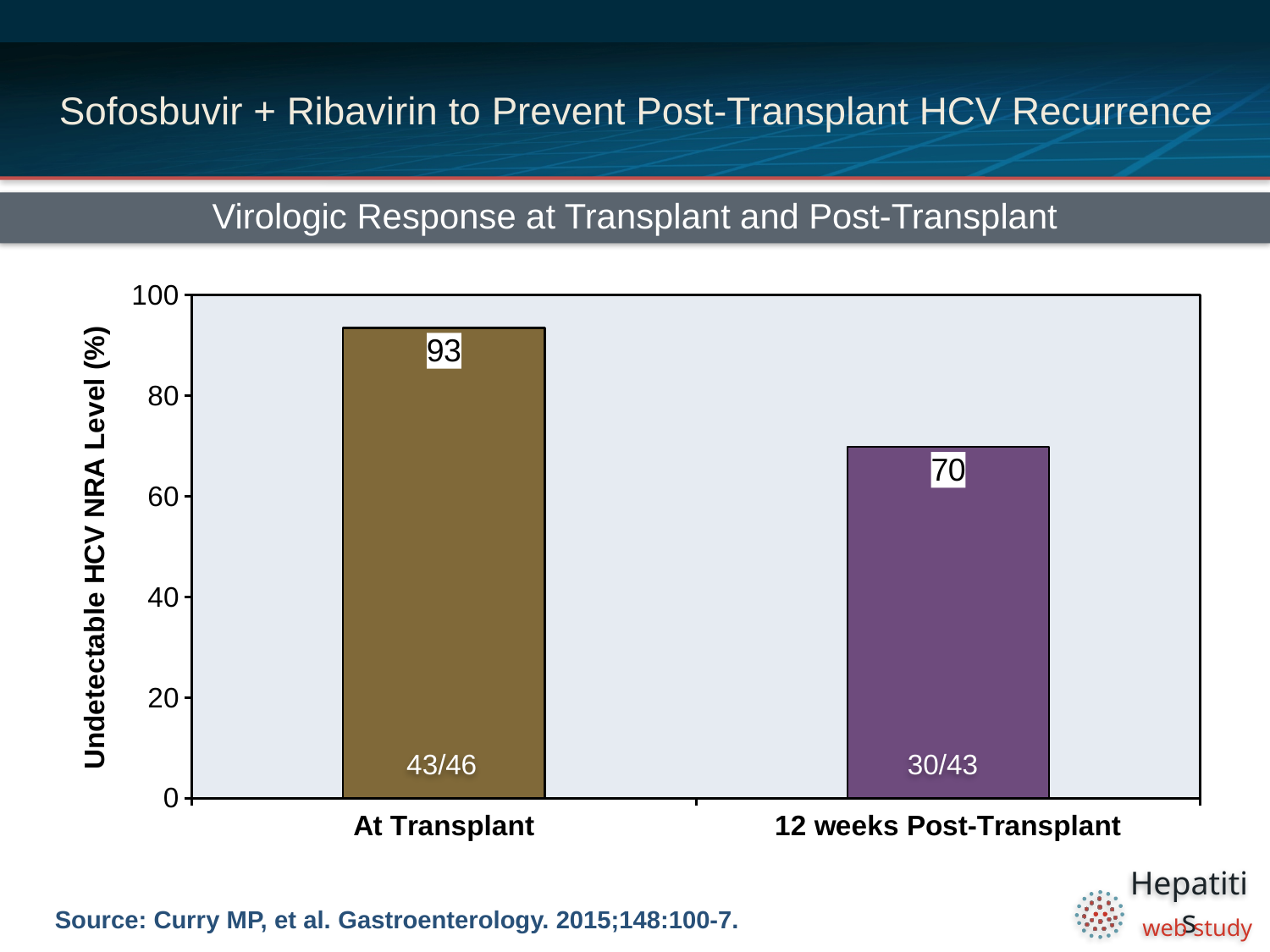
What is the value for 12 weeks Post-Transplant? 70 What kind of chart is shown on the slide? bar chart Which category has the lowest value? 12 weeks Post-Transplant Which category has the highest value? At Transplant Is the value for 12 weeks Post-Transplant greater or less than 80? less What fraction is printed inside the At Transplant bar? 43/46 What is the title of the chart? Virologic Response at Transplant and Post-Transplant What is the value for At Transplant? 93 What is the difference between the values for At Transplant and 12 weeks Post-Transplant? 23 Which is larger, the value for At Transplant or for 12 weeks Post-Transplant? At Transplant Do the values rise or fall from At Transplant to 12 weeks Post-Transplant? fall How many categories are shown on the x axis? 2